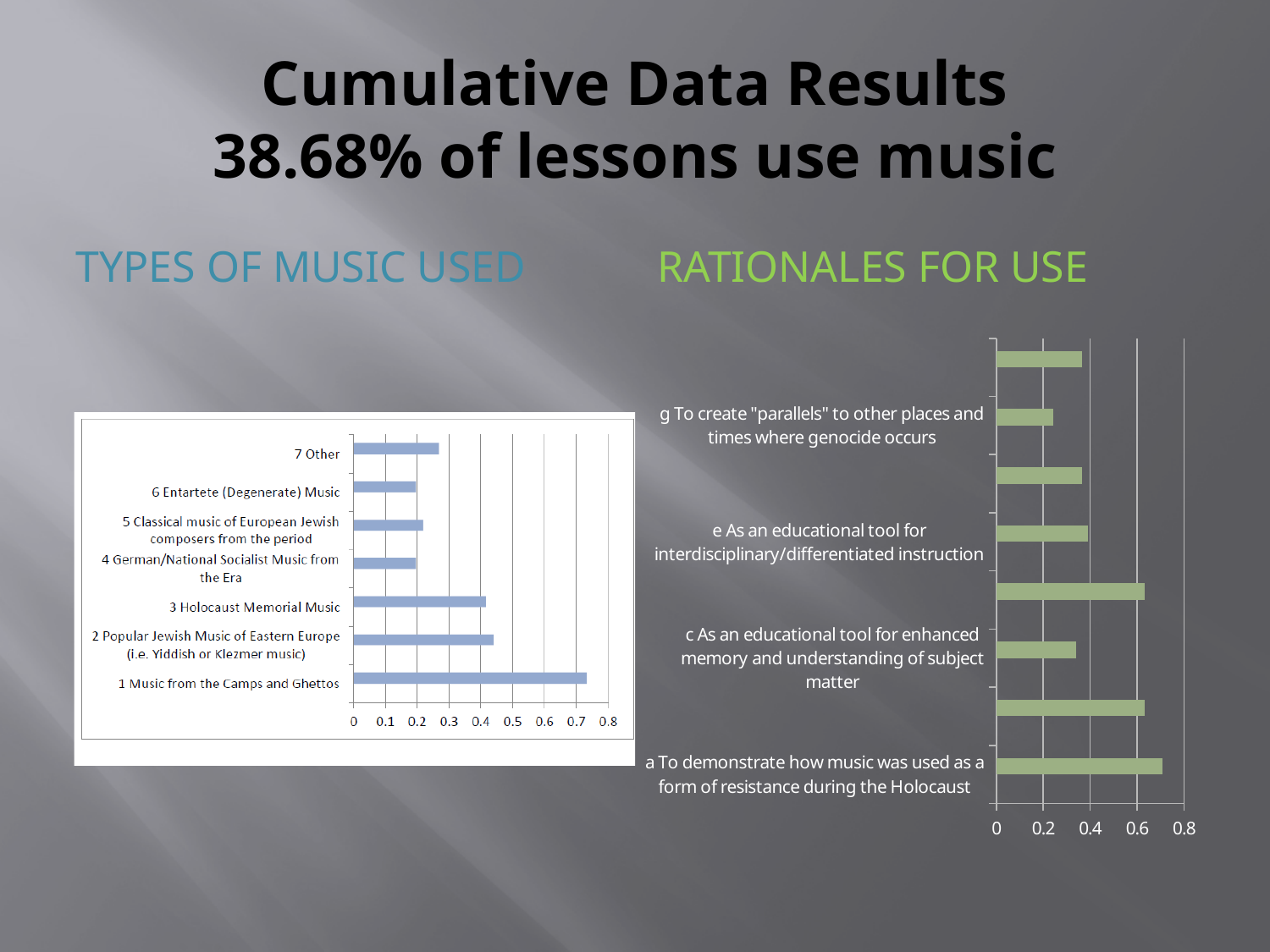
What kind of chart is the 'Rationales for Use' chart on the right? bar chart In the 'Types of Music Used' chart, is the value for '7 Other' greater or less than 0.3? less How many categories does the 'Types of Music Used' chart show? 7 In the 'Rationales for Use' chart, is the value for 'g To create "parallels" to other places and times where genocide occurs' greater or less than 0.4? less In the 'Types of Music Used' chart, is the value for '3 Holocaust Memorial Music' greater or less than 0.5? less In the 'Rationales for Use' chart, which is larger: rationale 'a' (music as resistance during the Holocaust) or rationale 'g' (parallels to other places and times where genocide occurs)? a To demonstrate how music was used as a form of resistance during the Holocaust What kind of chart is the 'Types of Music Used' chart on the left? bar chart In the 'Types of Music Used' chart, which is larger: '3 Holocaust Memorial Music' or '6 Entartete (Degenerate) Music'? 3 Holocaust Memorial Music What colour are the bars in the 'Rationales for Use' chart? green In the 'Types of Music Used' chart, which category has the highest value? 1 Music from the Camps and Ghettos